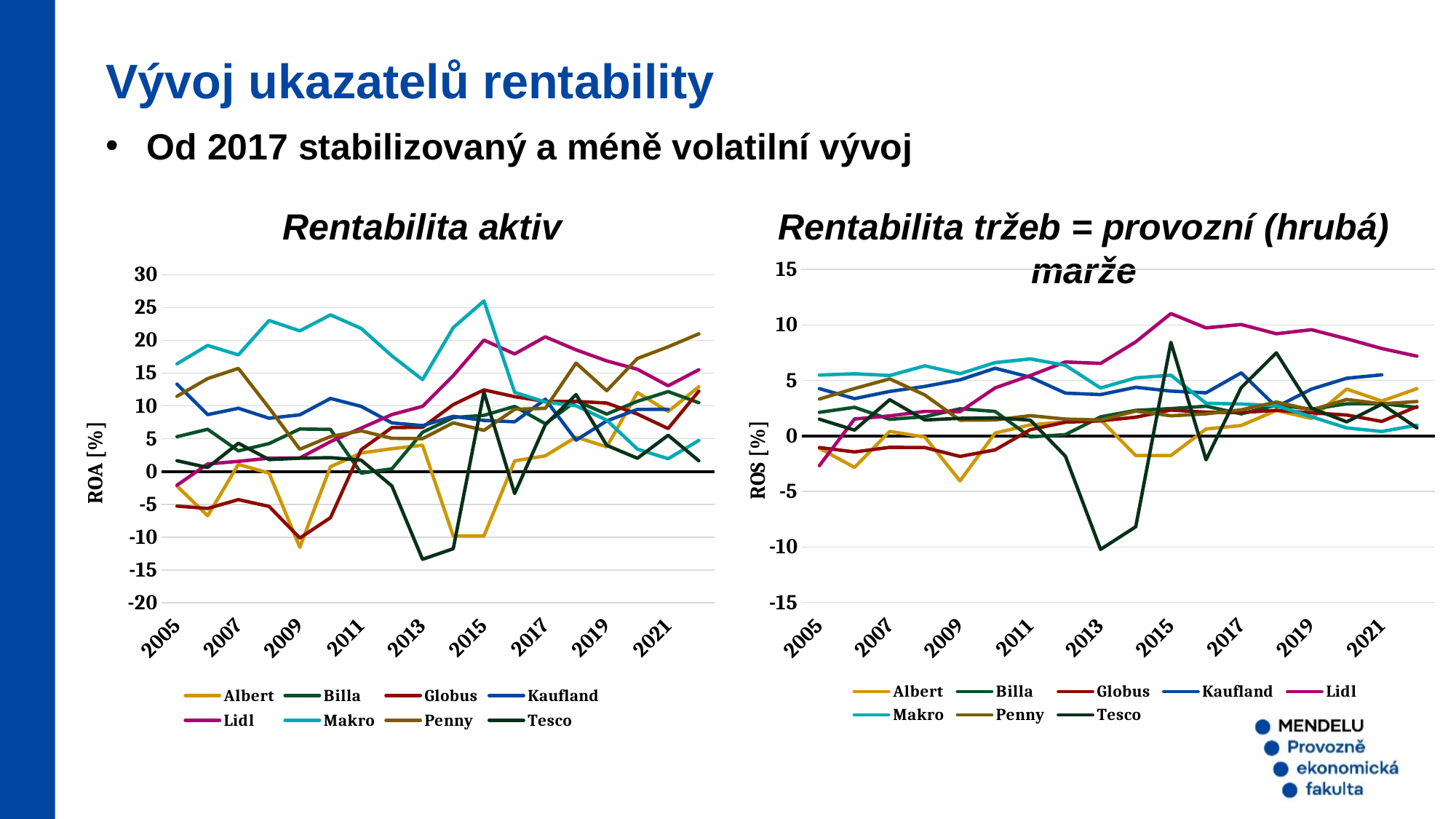
How many series does the legend of the 'Rentabilita aktiv' chart list? 8 How many series does the legend of the 'Rentabilita tržeb = provozní (hrubá) marže' chart list? 8 In the 'Rentabilita tržeb = provozní (hrubá) marže' chart, which series reaches the lowest value on the chart? Tesco In the 'Rentabilita aktiv' chart, which series reaches the lowest value on the chart? Tesco In the 'Rentabilita tržeb = provozní (hrubá) marže' chart, which series reaches the highest value on the chart? Lidl What type of chart is the 'Rentabilita aktiv' chart? line chart In the 'Rentabilita aktiv' chart, is the value for Tesco in 2013 greater or less than -10? less In the 'Rentabilita aktiv' chart, which series reaches the highest value on the chart? Makro In the 'Rentabilita tržeb = provozní (hrubá) marže' chart, is the value for Tesco in 2013 greater or less than -5? less What is the y-axis label of the 'Rentabilita aktiv' chart? ROA [%] In the 'Rentabilita tržeb = provozní (hrubá) marže' chart, is the value for Albert in 2009 greater or less than 0? less